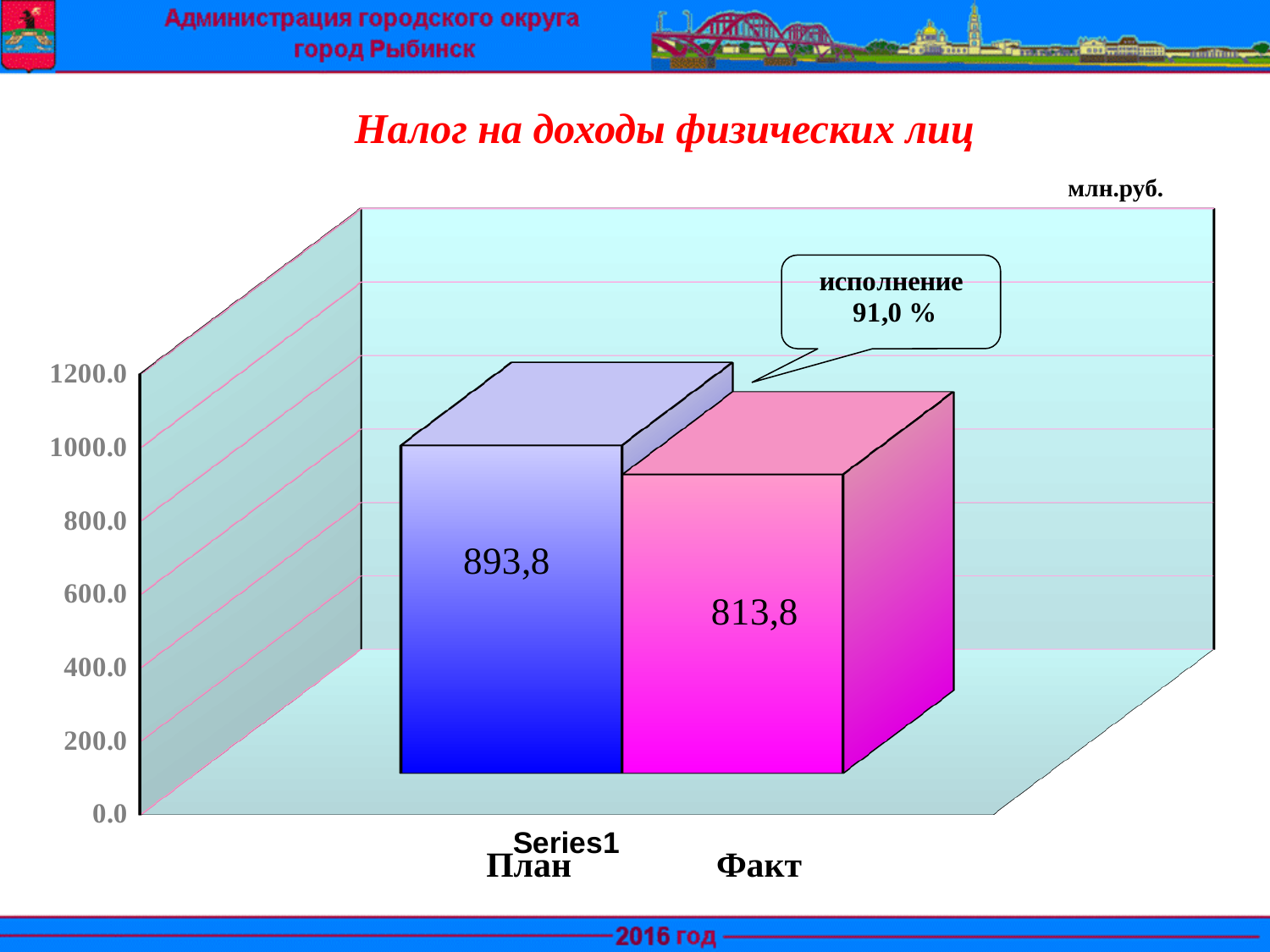
Which category has the highest value? План What is the difference between the План and Факт values? 80,0 Which category has the lowest value? Факт What kind of chart is shown on the slide? bar chart What is the value for План? 893,8 What is the title of the chart? Налог на доходы физических лиц Is the value for План greater or less than 800.0? greater How many bars are plotted in the chart? 2 What execution percentage (исполнение) is shown in the callout on the chart? 91,0 % Which bar is higher, План or Факт? План Is the value for Факт greater or less than 1000.0? less What is the value for Факт? 813,8